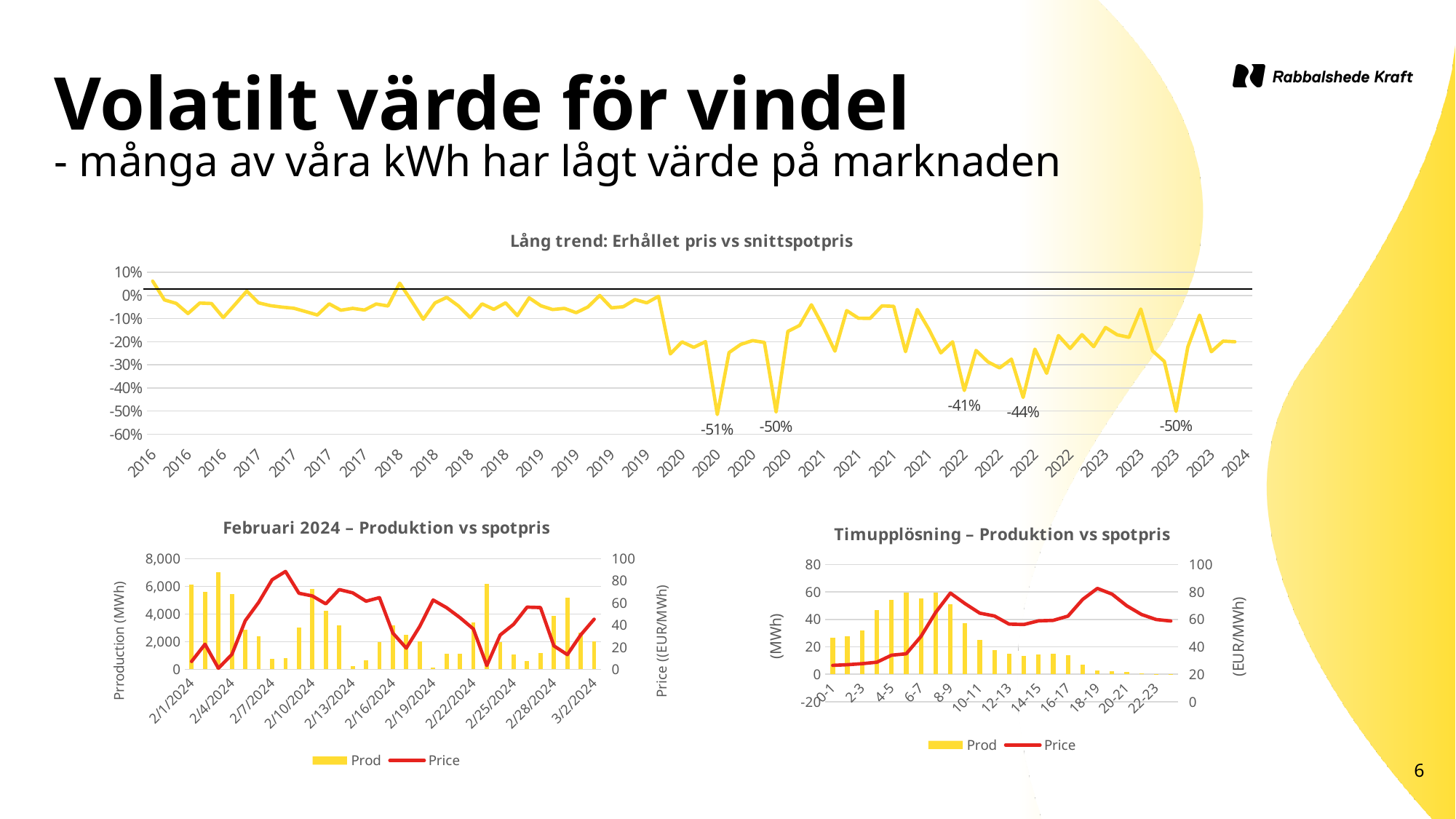
In the 'Lång trend: Erhållet pris vs snittspotpris' chart, what is the highest value printed as a data label? -41% In the 'Lång trend: Erhållet pris vs snittspotpris' chart, what is the lowest value printed as a data label? -51% In the 'Lång trend: Erhållet pris vs snittspotpris' chart, how many data labels are printed on the line? 5 In the 'Februari 2024 – Produktion vs spotpris' chart, what are the two legend entries? Prod and Price In the 'Timupplösning – Produktion vs spotpris' chart, do the Prod bars rise or fall from 8-9 to 22-23? fall In the 'Februari 2024 – Produktion vs spotpris' chart, is the Prod value on 2/1/2024 greater or less than 4,000? greater How many series does the legend of the 'Februari 2024 – Produktion vs spotpris' chart list? 2 In the 'Lång trend: Erhållet pris vs snittspotpris' chart, what labeled value appears in 2023? -50% In the 'Timupplösning – Produktion vs spotpris' chart, is the Prod value for 6-7 greater or less than 40? greater In the 'Timupplösning – Produktion vs spotpris' chart, is the Price value for 18-19 greater or less than 60? greater In the 'Lång trend: Erhållet pris vs snittspotpris' chart, what is the difference between the -41% label and the -51% label? 10 percentage points What kind of chart is 'Lång trend: Erhållet pris vs snittspotpris'? line chart